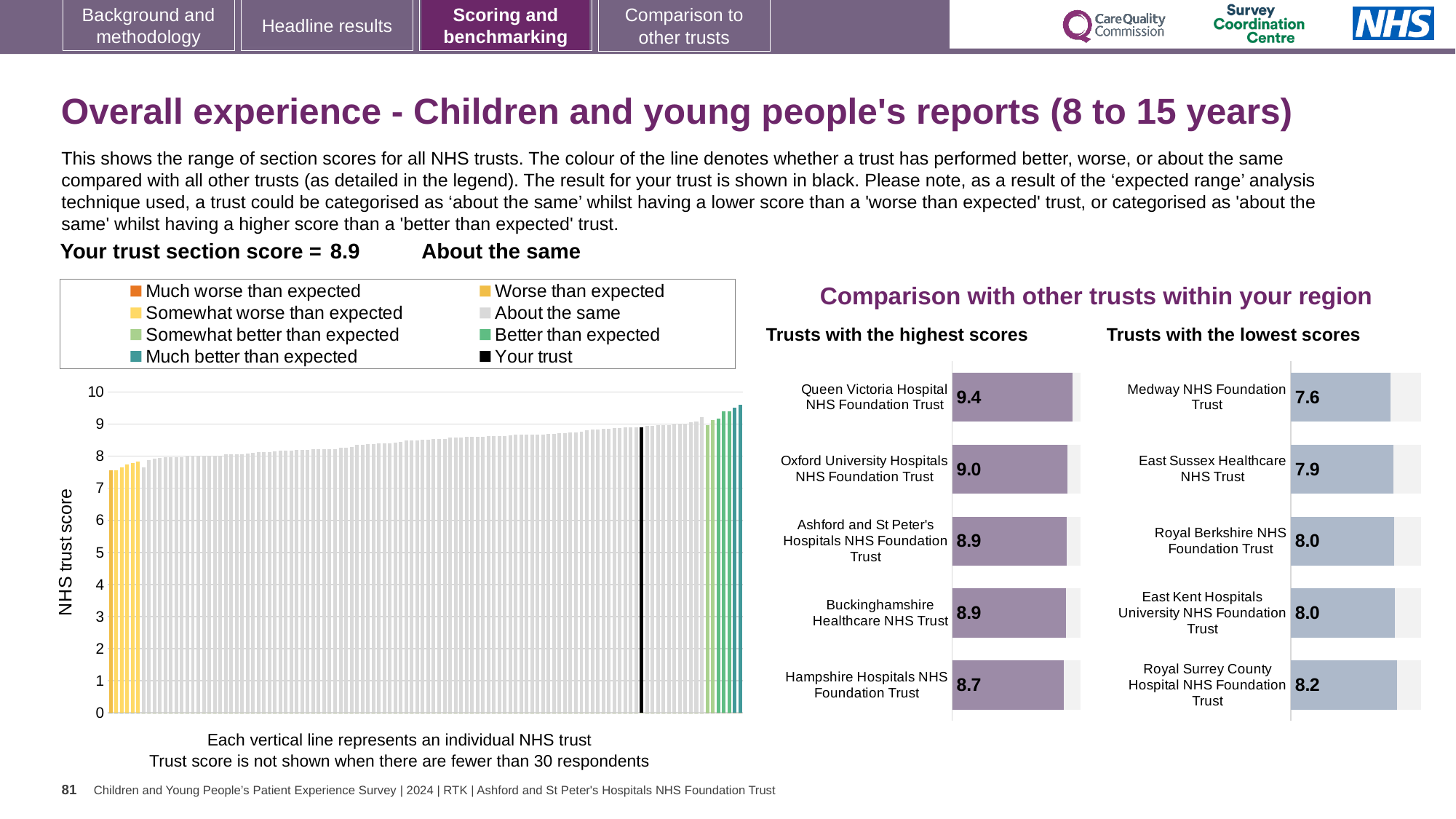
In the 'Trusts with the lowest scores' chart, what is the difference between the scores of Royal Surrey County Hospital NHS Foundation Trust and Medway NHS Foundation Trust? 0.6 In the 'Trusts with the highest scores' chart, which trust has the lowest score? Hampshire Hospitals NHS Foundation Trust In the 'Trusts with the lowest scores' chart, which trust has the highest score? Royal Surrey County Hospital NHS Foundation Trust In the NHS trust score chart on the left, do the bar values rise or fall from left to right along the x axis? Rise In the 'Trusts with the lowest scores' chart, what is the score for Medway NHS Foundation Trust? 7.6 In the 'Trusts with the highest scores' chart, what is the difference between the scores of Queen Victoria Hospital NHS Foundation Trust and Hampshire Hospitals NHS Foundation Trust? 0.7 In the 'Trusts with the lowest scores' chart, which has the higher score: East Sussex Healthcare NHS Trust or Royal Berkshire NHS Foundation Trust? Royal Berkshire NHS Foundation Trust What kind of chart is the NHS trust score chart on the left of the slide? Bar chart How many trusts are shown in the 'Trusts with the highest scores' chart? 5 In the 'Trusts with the highest scores' chart, what is the score for Queen Victoria Hospital NHS Foundation Trust? 9.4 In the NHS trust score chart on the left, is the value for the black 'Your trust' bar greater or less than 8? greater How many entries does the legend of the NHS trust score chart on the left list? 8